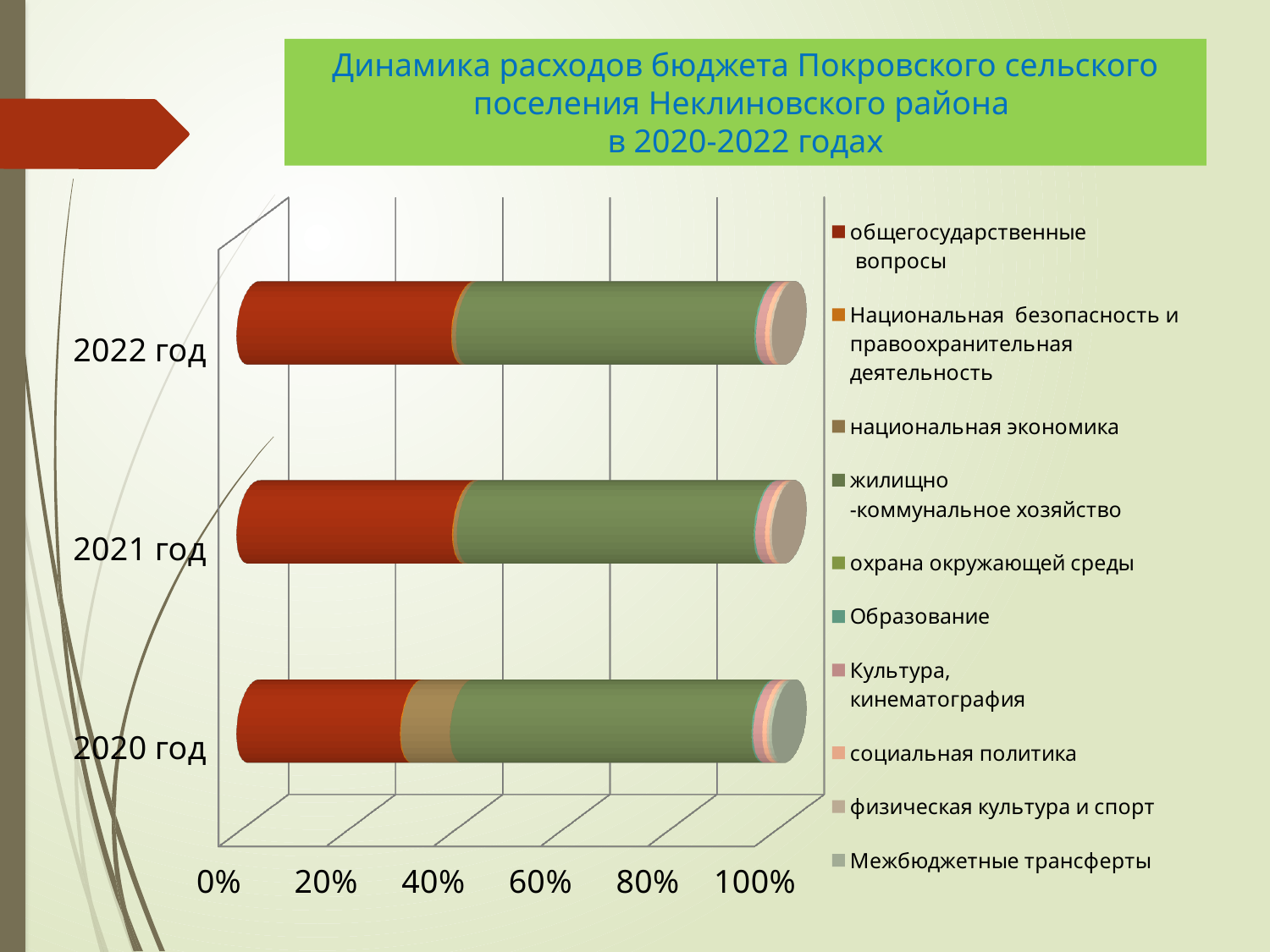
Is the share of общегосударственные вопросы in 2022 год greater or less than 20%? greater How many series does the legend list? 10 What is the highest value shown on the horizontal axis? 100% What kind of chart is shown on the slide? Stacked bar chart Is the share of общегосударственные вопросы in 2021 год greater or less than 60%? less How many years (categories) are shown on the chart? 3 What is the first entry in the chart legend? общегосударственные вопросы Is the share of общегосударственные вопросы in 2020 год greater or less than 40%? less In 2020 год, which segment is larger: общегосударственные вопросы or национальная экономика? общегосударственные вопросы In 2022 год, which segment is larger: общегосударственные вопросы or жилищно-коммунальное хозяйство? жилищно-коммунальное хозяйство Which year has the largest share of общегосударственные вопросы: 2020 год or 2022 год? 2022 год Which years are shown as categories on the chart? 2020 год, 2021 год, 2022 год